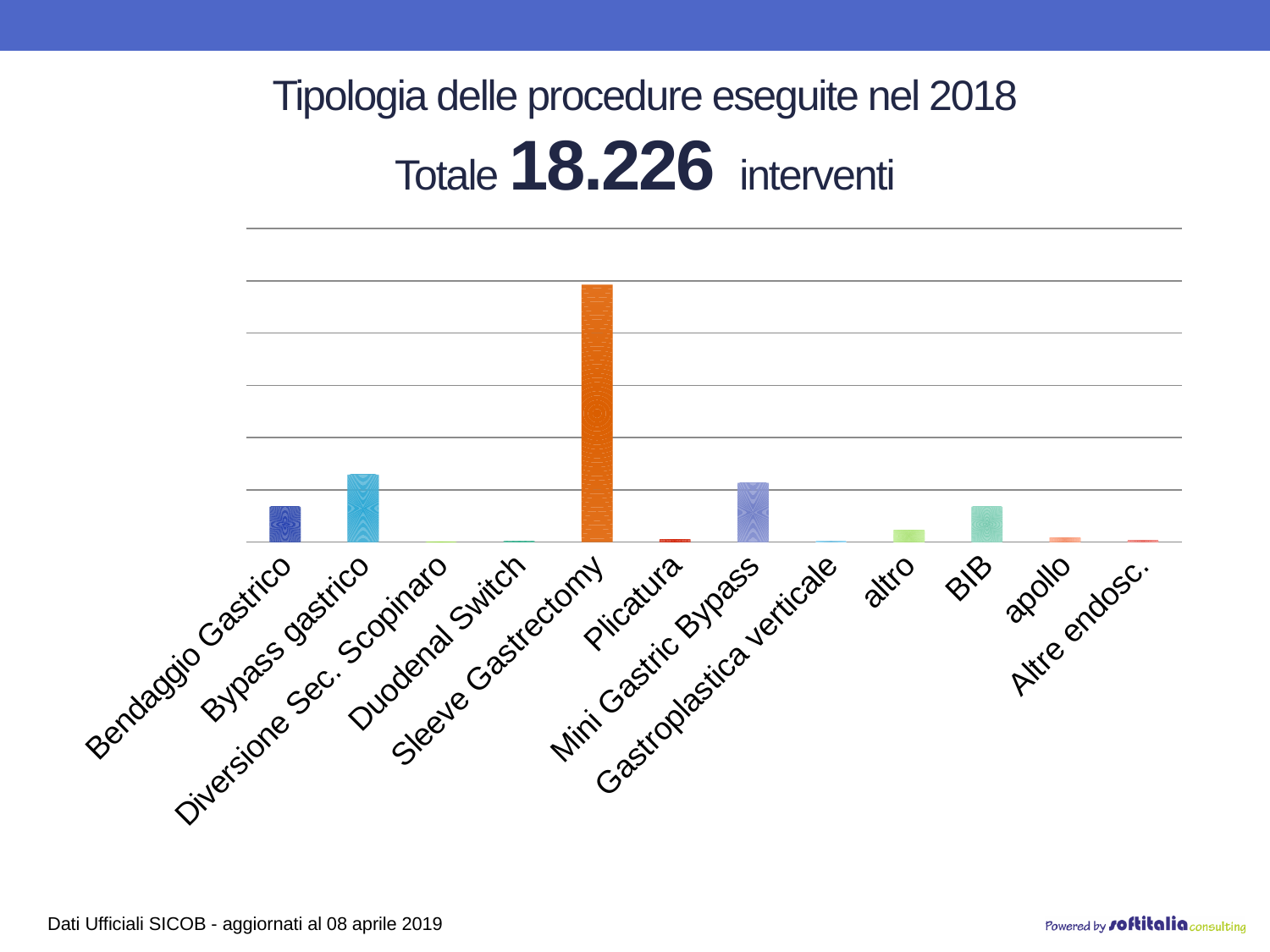
Which is larger, the value for Mini Gastric Bypass or the value for BIB? Mini Gastric Bypass What kind of chart is shown on the slide? bar chart Which is larger, the value for BIB or the value for altro? BIB Which is larger, the value for altro or the value for Duodenal Switch? altro Which procedure has the highest bar in the chart? Sleeve Gastrectomy How many procedure categories are shown on the x axis of the chart? 12 What is the title of the chart on the slide? Tipologia delle procedure eseguite nel 2018 What total number of interventions is stated above the chart? 18.226